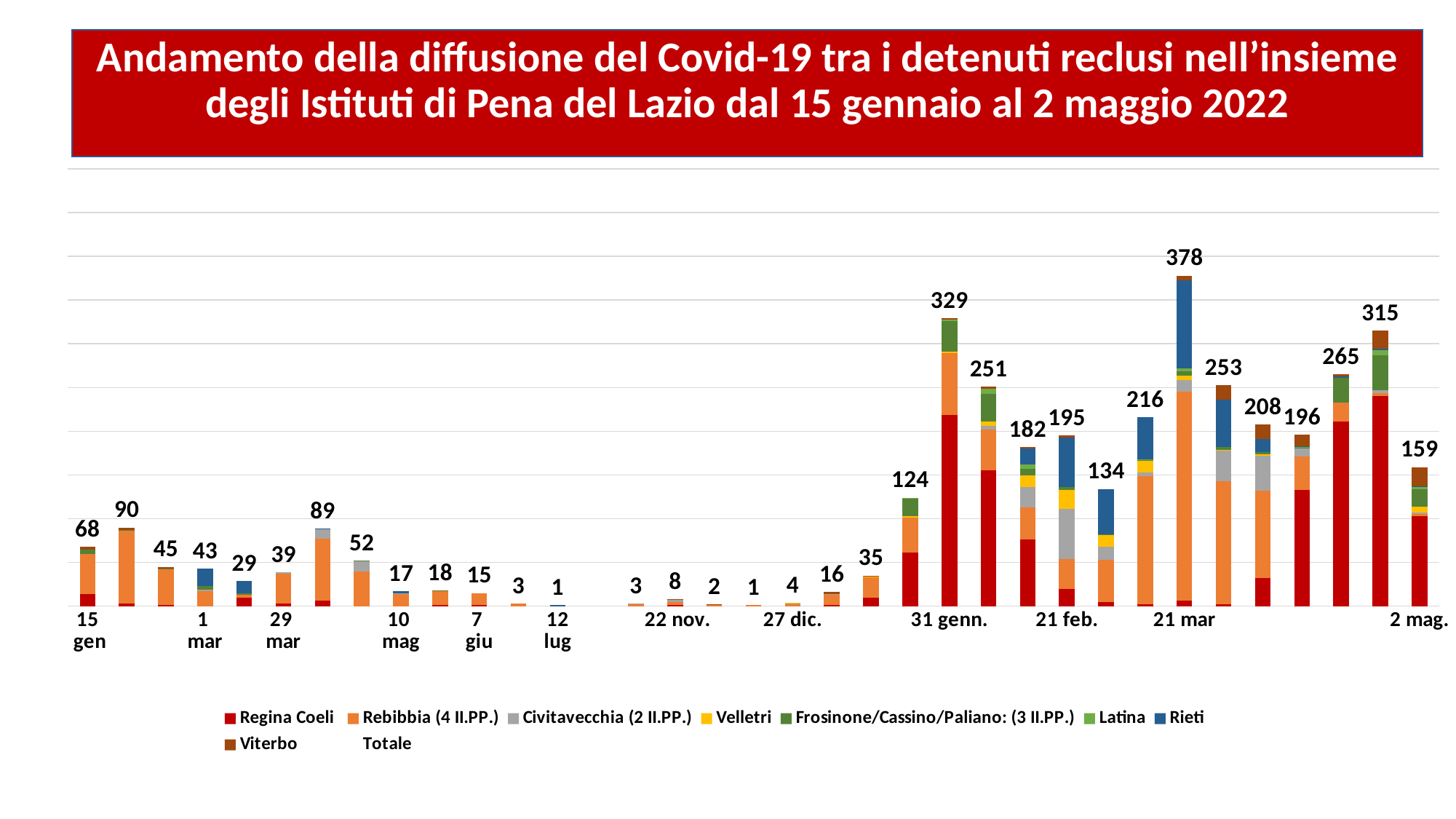
What is the difference between the totals for 21 mar and 31 genn.? 49 How many entries does the legend list? 9 What kind of chart is shown on the slide? Stacked bar chart Which has the larger total, 31 genn. or 21 feb.? 31 genn. Which series is shown in red in the legend? Regina Coeli What is the total for 1 mar? 43 What is the total for 2 mag.? 159 What is the highest total shown on the chart? 378 On which date does the chart reach its highest total? 21 mar What is the total for 15 gen? 68 What is the total for 22 nov.? 8 What is the total for 31 genn.? 329